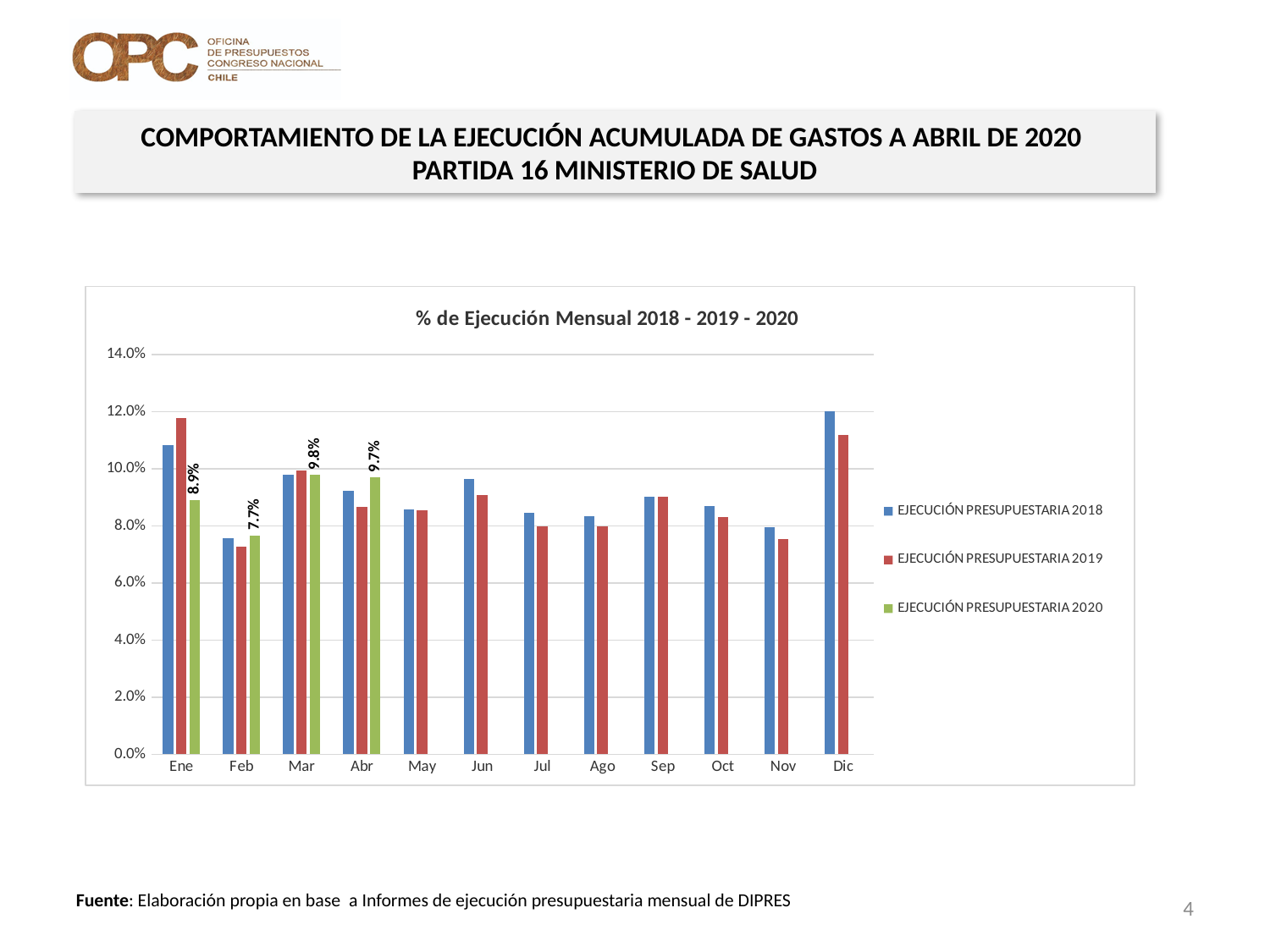
What is the value for EJECUCIÓN PRESUPUESTARIA 2020 in Abr? 9.7% What is the value for EJECUCIÓN PRESUPUESTARIA 2020 in Ene? 8.9% How many months are shown on the x axis? 12 What is the value for EJECUCIÓN PRESUPUESTARIA 2020 in Feb? 7.7% How many series does the legend list? 3 Which month has the lowest value for EJECUCIÓN PRESUPUESTARIA 2020? Feb What is the difference between the EJECUCIÓN PRESUPUESTARIA 2020 values for Mar and Feb? 2.1% Which is larger in Dic: EJECUCIÓN PRESUPUESTARIA 2018 or EJECUCIÓN PRESUPUESTARIA 2019? EJECUCIÓN PRESUPUESTARIA 2018 Which month has the highest value for EJECUCIÓN PRESUPUESTARIA 2020? Mar What is the value for EJECUCIÓN PRESUPUESTARIA 2020 in Mar? 9.8% What kind of chart is shown on the slide? Bar chart Is the value for EJECUCIÓN PRESUPUESTARIA 2018 in Dic greater or less than 10.0%? greater